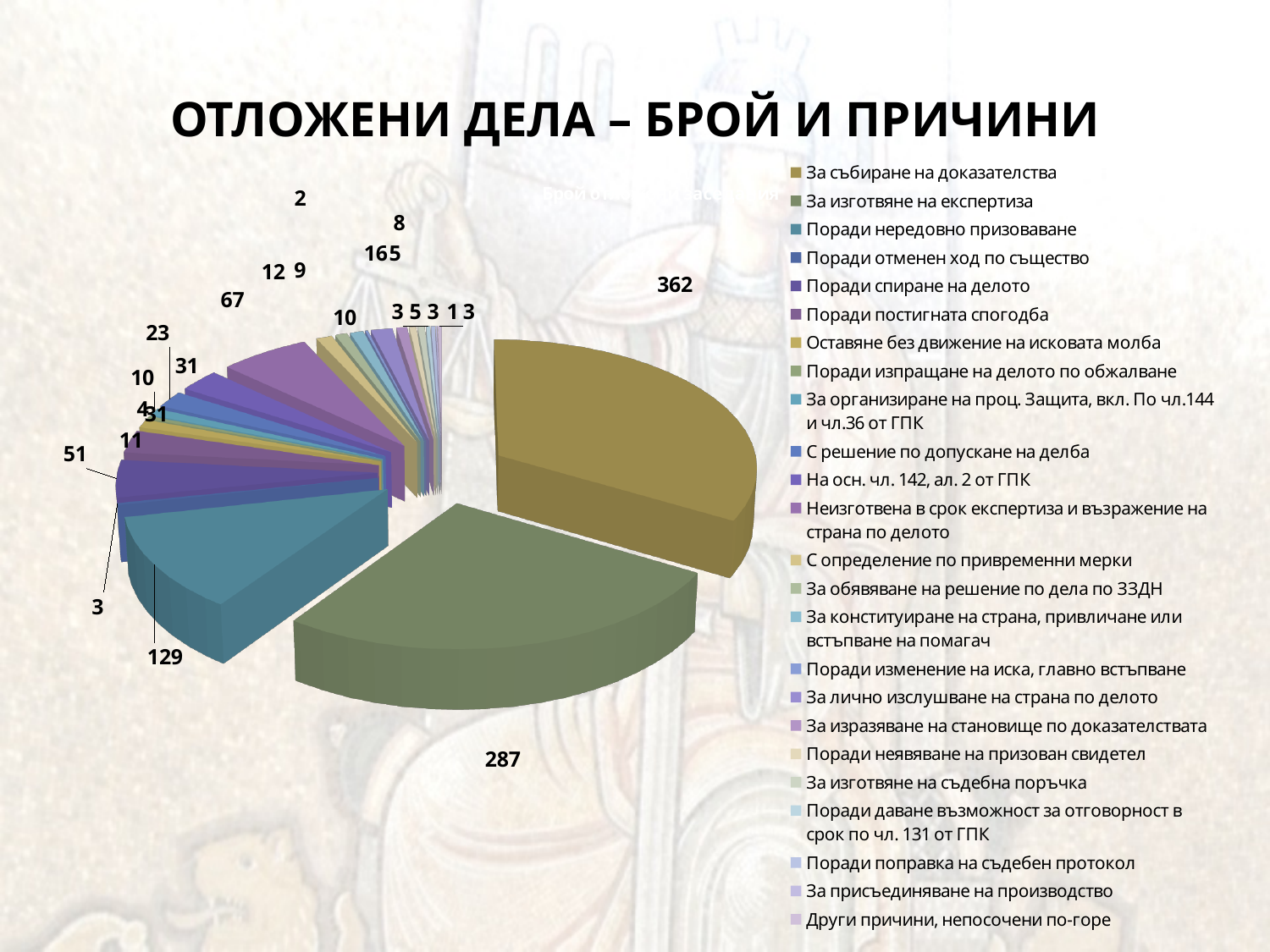
What is the difference between the values for За събиране на доказателства and За изготвяне на експертиза? 75 What is the smallest value labelled on the pie chart? 1 Which is larger, the value for За събиране на доказателства or the value for За изготвяне на експертиза? За събиране на доказателства What is the value for Поради нередовно призоваване? 129 How many categories does the legend list? 24 What kind of chart is shown on the slide? pie chart What is the difference between the values for За изготвяне на експертиза and Поради нередовно призоваване? 158 Which category has the largest slice of the pie? За събиране на доказателства What is the value for За събиране на доказателства? 362 What is the title of the slide? ОТЛОЖЕНИ ДЕЛА – БРОЙ И ПРИЧИНИ Which is larger, the value for Поради нередовно призоваване or the value for За изготвяне на експертиза? За изготвяне на експертиза What is the value for За изготвяне на експертиза? 287